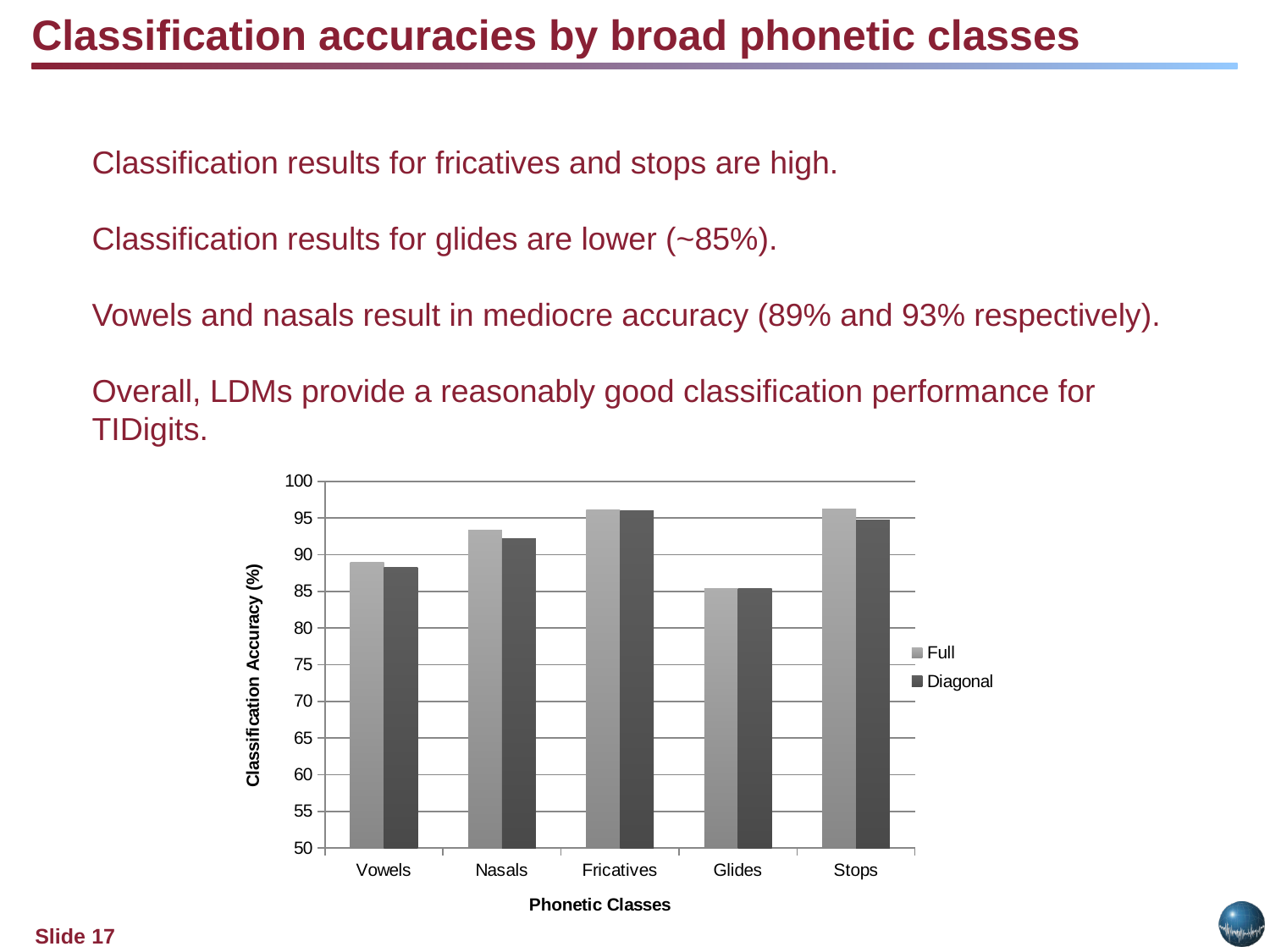
What is the label of the chart's y axis? Classification Accuracy (%) Is the Full classification accuracy for Glides greater or less than 90? less What kind of chart is shown on the slide? bar chart How many phonetic classes are shown on the x axis of the chart? 5 For the Full series, which has the higher classification accuracy, Vowels or Nasals? Nasals Which phonetic class has the lowest classification accuracy for the Diagonal series? Glides Is the Full classification accuracy for Vowels greater or less than 85? greater Is the Diagonal classification accuracy for Stops greater or less than 90? greater How many series does the chart's legend list? 2 Which phonetic class has the lowest classification accuracy for the Full series? Glides For Stops, which series has the higher classification accuracy, Full or Diagonal? Full